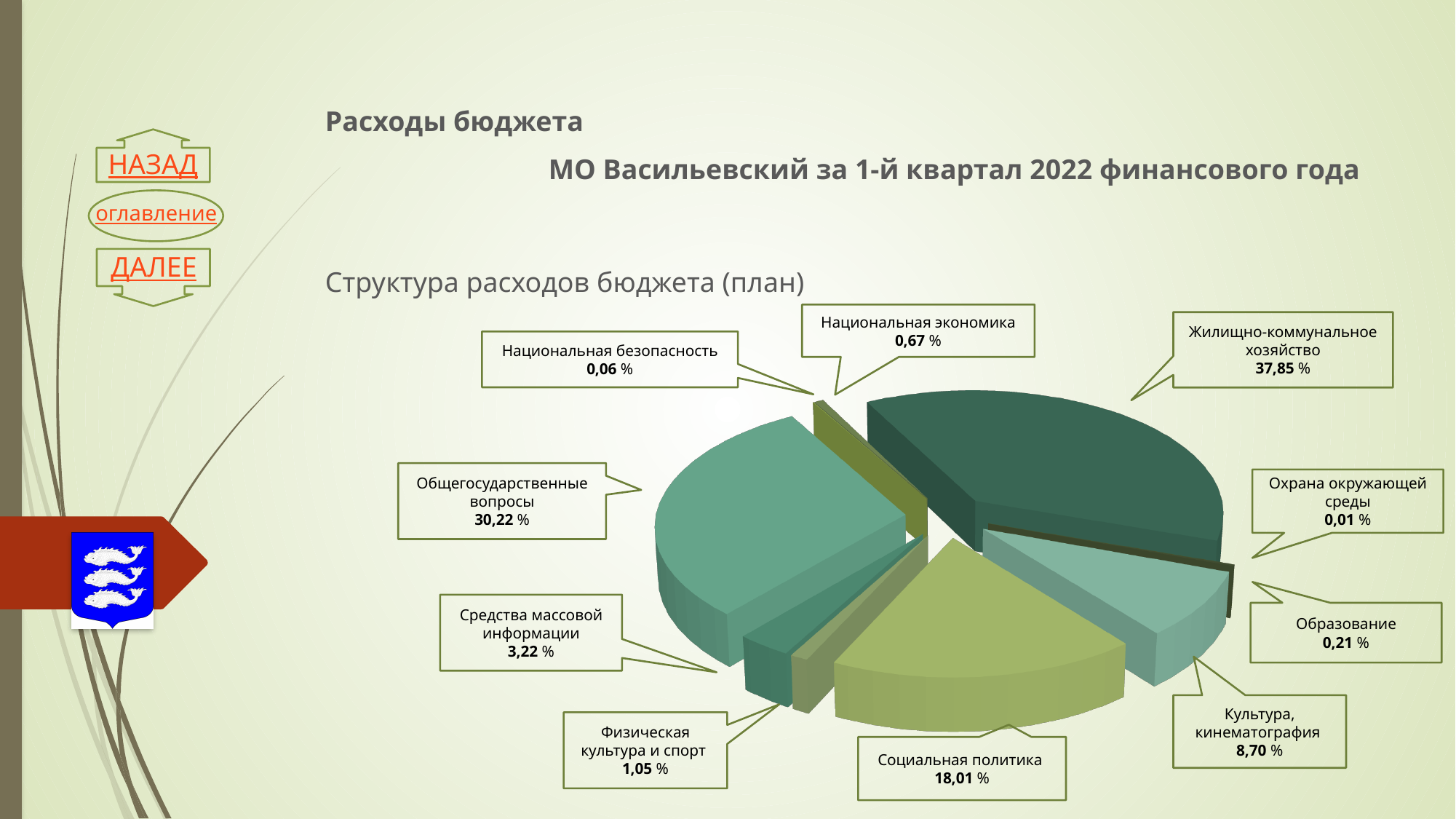
What is the title of the chart? Структура расходов бюджета (план) What kind of chart is shown on the slide? pie chart Which category has the largest share of the pie? Жилищно-коммунальное хозяйство What is the share for Средства массовой информации? 3,22 % What is the share for Культура, кинематография? 8,70 % What is the share for Социальная политика? 18,01 % How many categories are shown in the pie chart? 10 What is the share for Жилищно-коммунальное хозяйство? 37,85 % Which category has the smallest share of the pie? Охрана окружающей среды What is the difference between the shares of Жилищно-коммунальное хозяйство and Общегосударственные вопросы? 7,63 % Which is larger: the share for Социальная политика or the share for Культура, кинематография? Социальная политика What is the share for Общегосударственные вопросы? 30,22 %